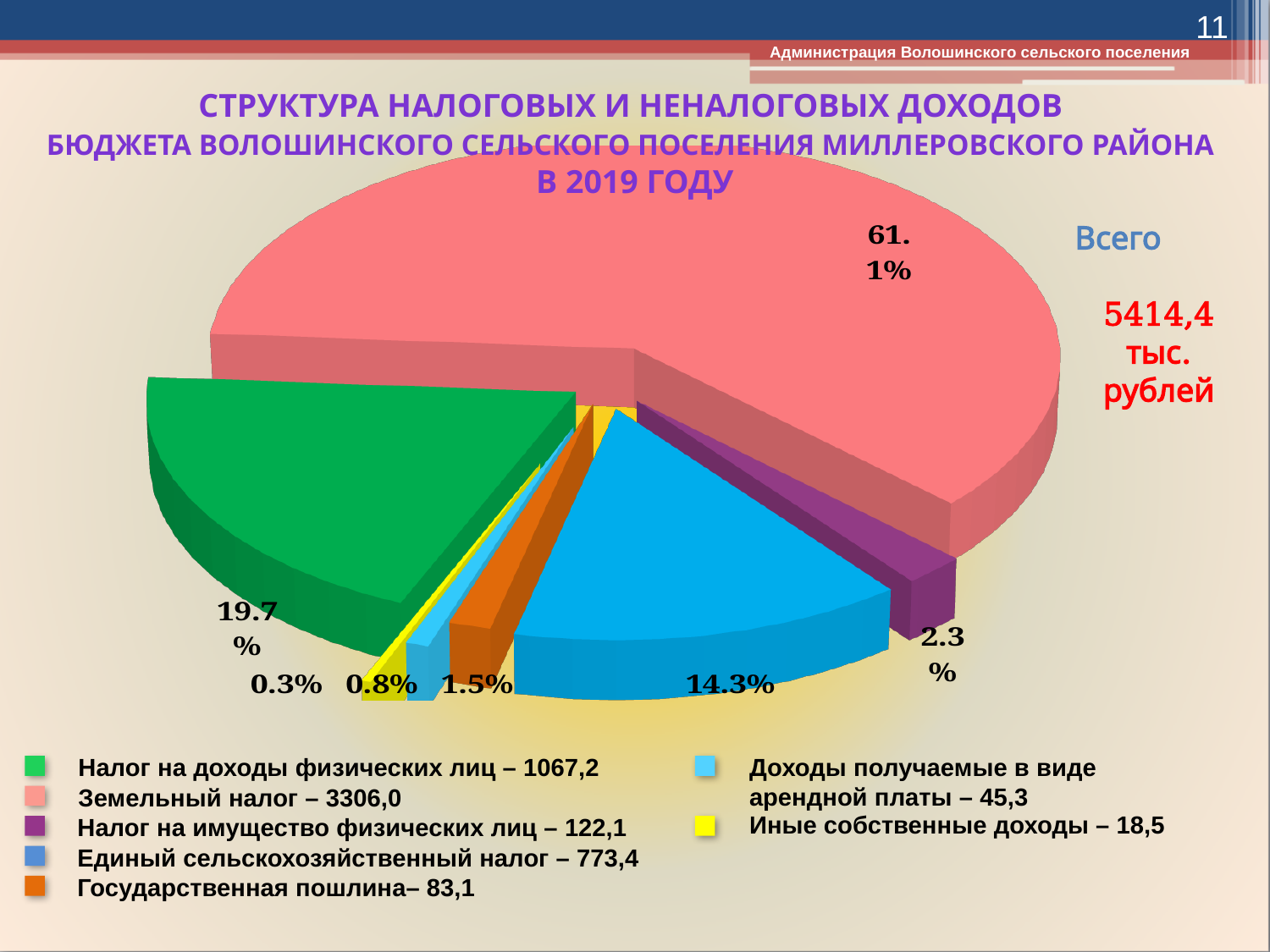
What percentage is shown for the green slice (Налог на доходы физических лиц)? 19.7% What percentage is shown for the blue slice (Единый сельскохозяйственный налог)? 14.3% According to the legend, what is the value for Единый сельскохозяйственный налог? 773,4 Which is larger: the share for Государственная пошлина or the share for Доходы получаемые в виде арендной платы? Государственная пошлина Which category has the smallest share of the pie? Иные собственные доходы What total amount (Всего) is shown next to the pie chart? 5414,4 тыс. рублей Which category has the largest share of the pie? Земельный налог How many slices does the pie chart have? 7 What share of the pie does the largest slice (Земельный налог) represent? 61.1% What kind of chart is shown on the slide? pie chart What is the difference in percentage points between the Земельный налог slice (61.1%) and the Налог на доходы физических лиц slice (19.7%)? 41.4 What percentage is shown for the purple slice (Налог на имущество физических лиц)? 2.3%